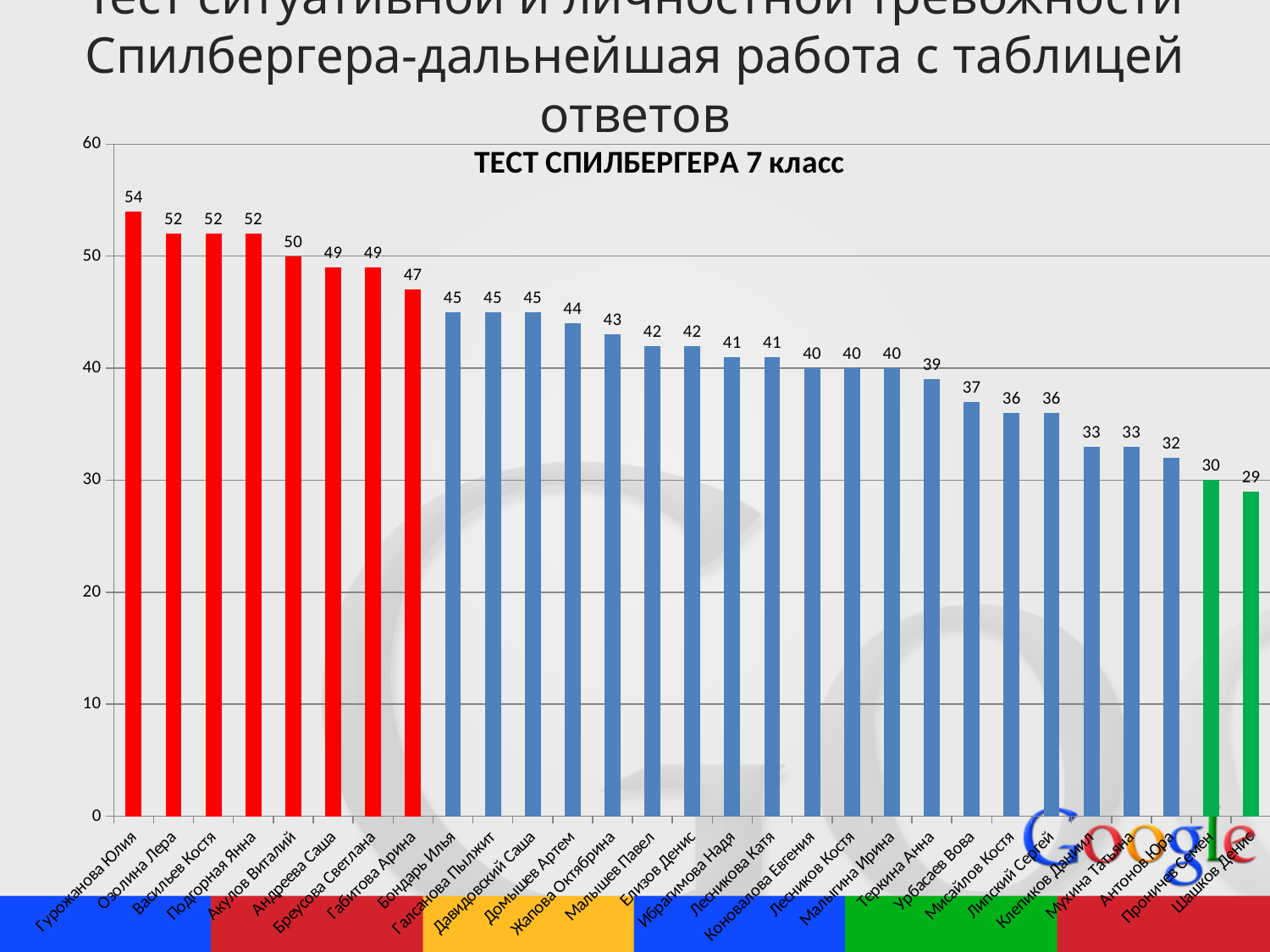
What is the title of the chart? ТЕСТ СПИЛБЕРГЕРА 7 класс Do the values rise or fall from left to right along the x axis? Fall How many people (bars) are shown on the chart? 29 What is the value for Гурожанова Юлия? 54 Which person has the highest value on the chart? Гурожанова Юлия Who has the larger value, Габитова Арина or Бондарь Илья? Габитова Арина What is the difference between the values for Гурожанова Юлия and Шашков Денис? 25 Which person has the lowest value on the chart? Шашков Денис What kind of chart is shown on the slide? Bar chart Is the value for Урбасаев Вова greater or less than 40? less What is the value for Проничев Семен? 30 What is the value for Акулов Виталий? 50